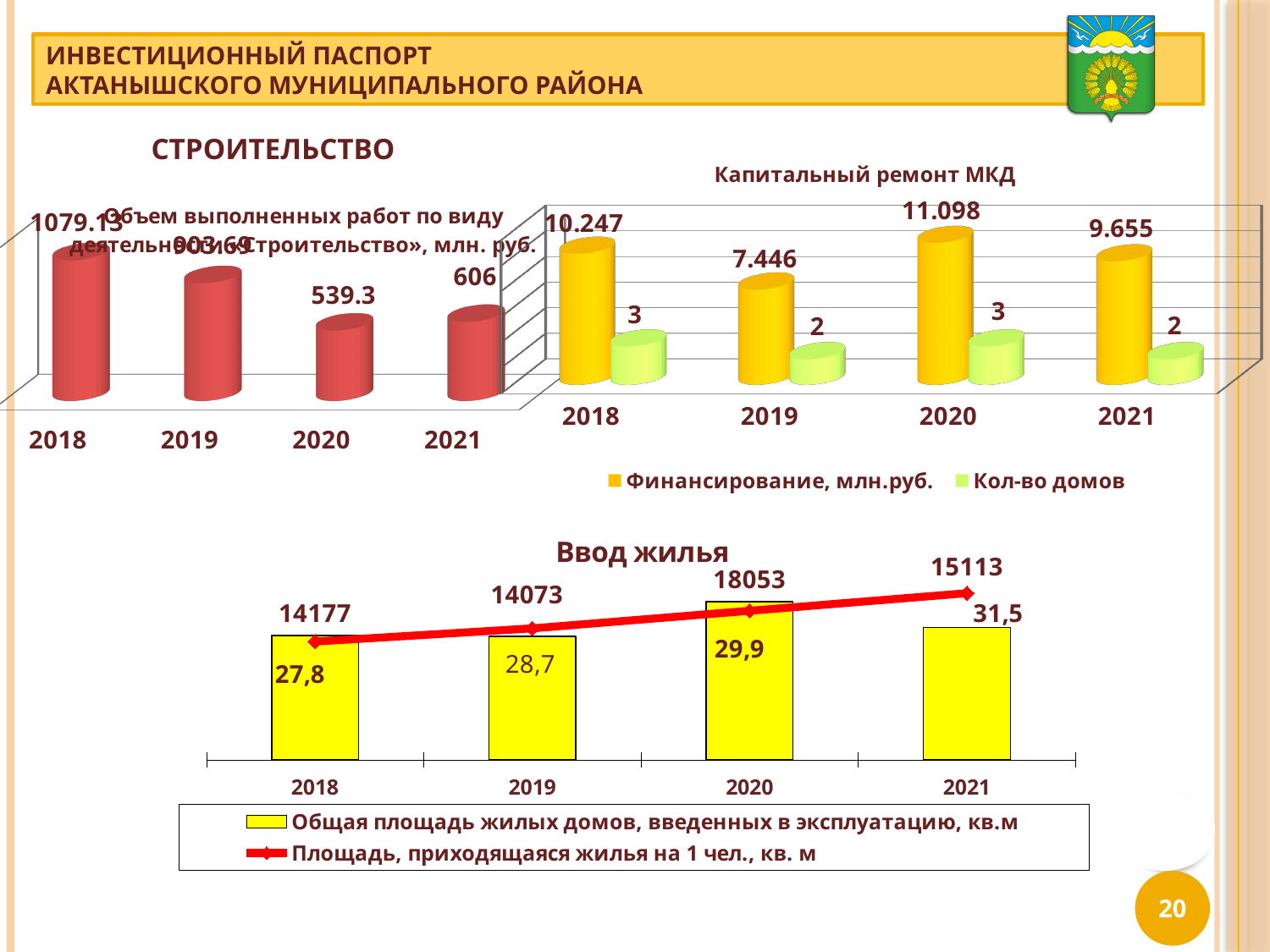
In the chart 'Ввод жилья', what is the value of 'Площадь, приходящаяся жилья на 1 чел., кв. м' for 2021? 31,5 In the top-left chart 'Объем выполненных работ по виду деятельности «Строительство», млн. руб.', which is larger: the value for 2020 or the value for 2021? 2021 How many years are shown on the x axis of the chart 'Ввод жилья'? 4 In the chart 'Ввод жилья', which year has the highest value of 'Общая площадь жилых домов, введенных в эксплуатацию, кв.м'? 2020 In the chart 'Ввод жилья', does the line 'Площадь, приходящаяся жилья на 1 чел., кв. м' rise or fall from 2018 to 2021? rise In the chart 'Капитальный ремонт МКД', what is the value of 'Финансирование, млн.руб.' for 2020? 11.098 In the chart 'Ввод жилья', what is the value of 'Общая площадь жилых домов, введенных в эксплуатацию, кв.м' for 2020? 18053 In the chart 'Капитальный ремонт МКД', what is the value of 'Кол-во домов' for 2021? 2 In the chart 'Капитальный ремонт МКД', how many series does the legend list? 2 In the chart 'Ввод жилья', what is the difference between the 2020 and 2019 values of 'Общая площадь жилых домов, введенных в эксплуатацию, кв.м'? 3980 In the top-left chart 'Объем выполненных работ по виду деятельности «Строительство», млн. руб.', what is the value for 2020? 539.3 In the chart 'Капитальный ремонт МКД', which year has the lowest value of 'Финансирование, млн.руб.'? 2019